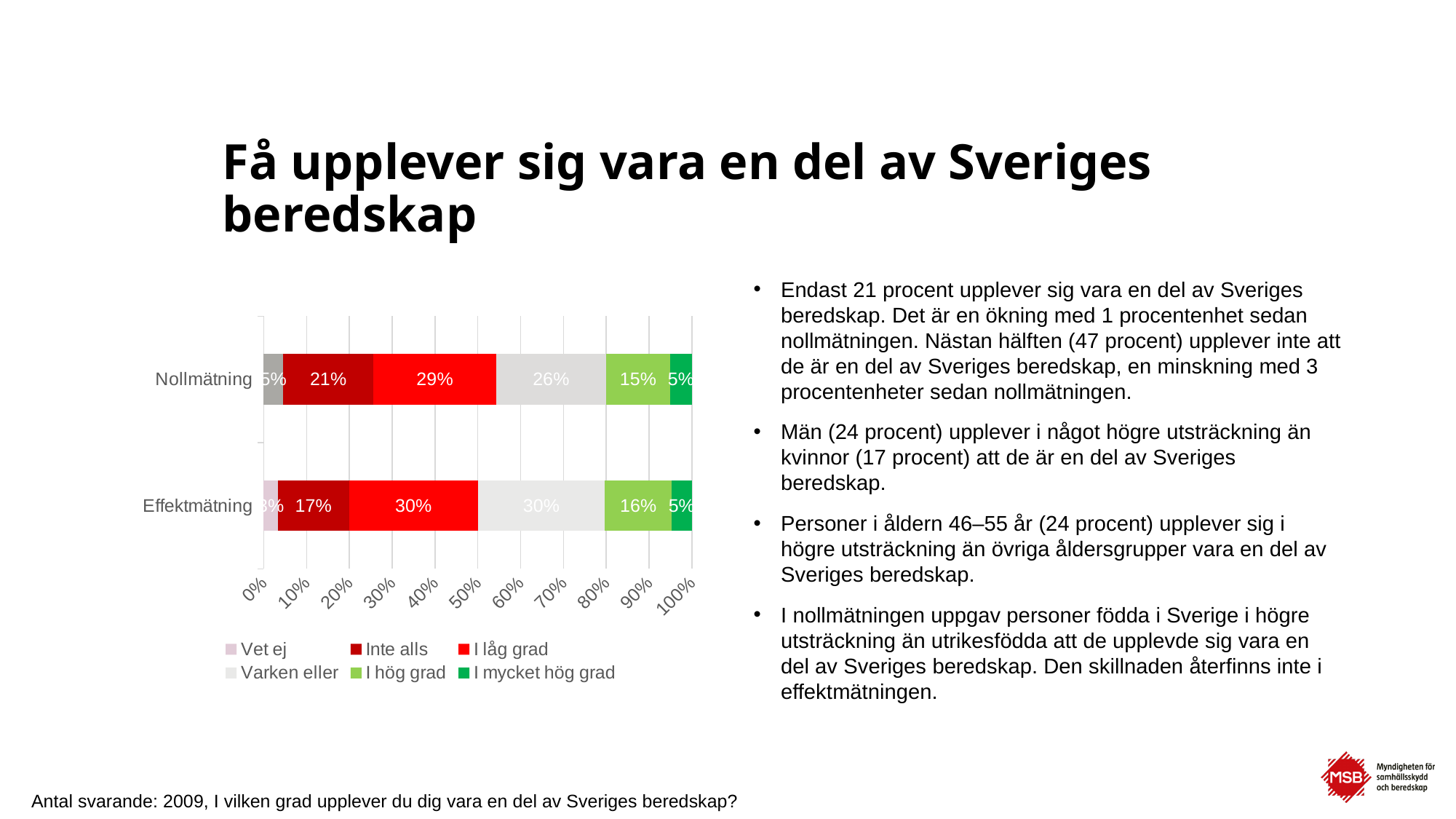
Which bar has the larger 'Varken eller' value, Nollmätning or Effektmätning? Effektmätning What is the value for 'I låg grad' in the Effektmätning bar? 30% What kind of chart is shown on the slide? Stacked bar chart What is the value for 'I hög grad' in the Effektmätning bar? 16% Which series has the largest value in the Nollmätning bar? I låg grad Which legend entry is shown in dark green? I mycket hög grad How many series does the legend list? 6 What is the value for 'Varken eller' in the Nollmätning bar? 26% What is the value for 'I mycket hög grad' in the Nollmätning bar? 5% What is the value for 'Inte alls' in the Nollmätning bar? 21% What is the difference between the 'Inte alls' values for Nollmätning and Effektmätning? 4 percentage points How many categories (bars) are shown in the chart? 2